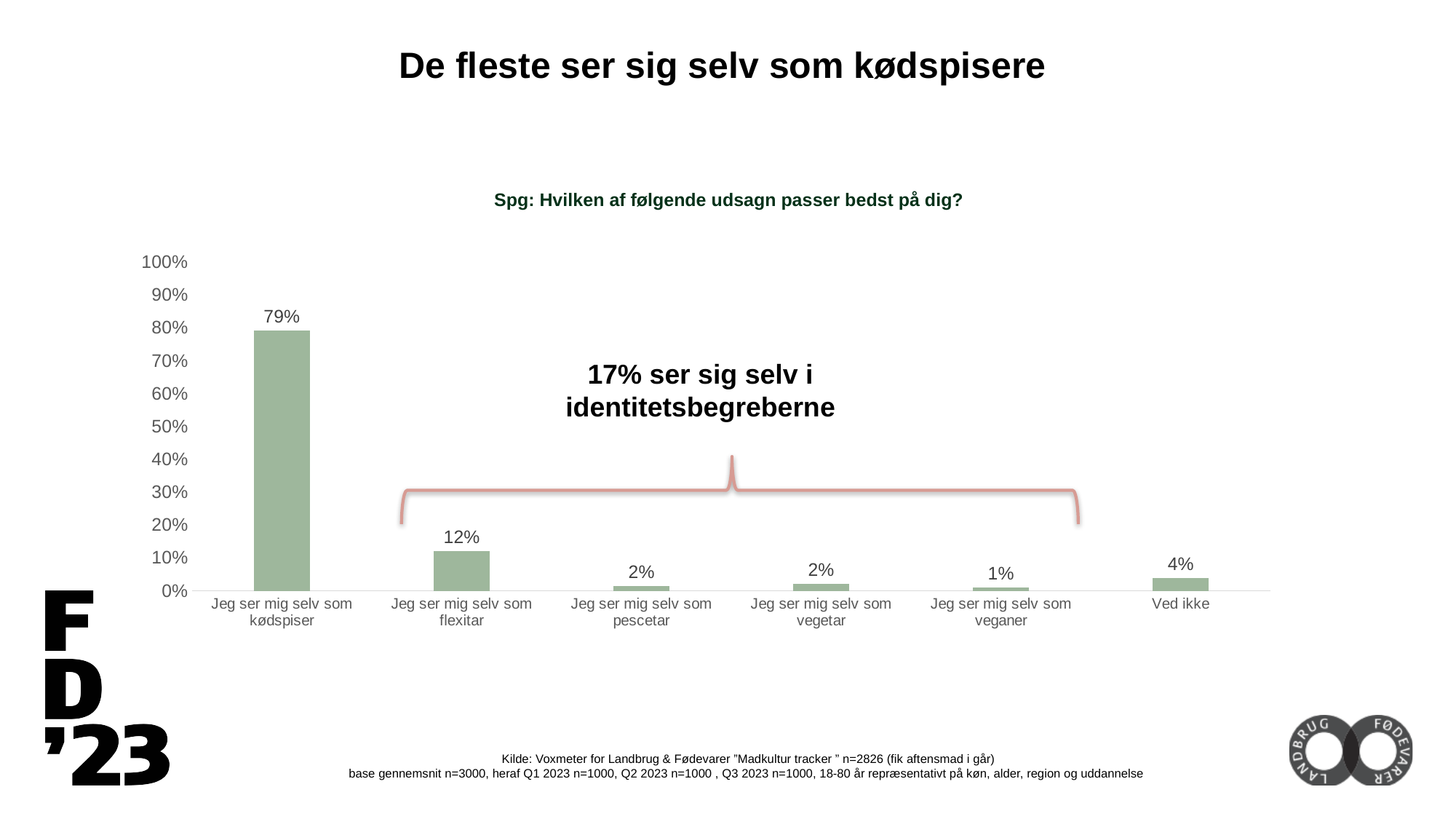
What kind of chart is shown on the slide? Bar chart Which category has the lowest value? Jeg ser mig selv som veganer Which category has the highest value? Jeg ser mig selv som kødspiser What is the difference between the 'kødspiser' and 'flexitar' values? 67 percentage points What is the value for 'Jeg ser mig selv som flexitar'? 12% Which is larger, the value for 'flexitar' or the value for 'Ved ikke'? Jeg ser mig selv som flexitar How many categories are shown on the x axis? 6 What percentage of respondents see themselves as 'kødspiser'? 79% Is the value for 'Jeg ser mig selv som kødspiser' greater or less than 70%? greater What is the survey question shown above the chart? Spg: Hvilken af følgende udsagn passer bedst på dig? What is the value for 'Ved ikke'? 4% What is the value for 'Jeg ser mig selv som veganer'? 1%